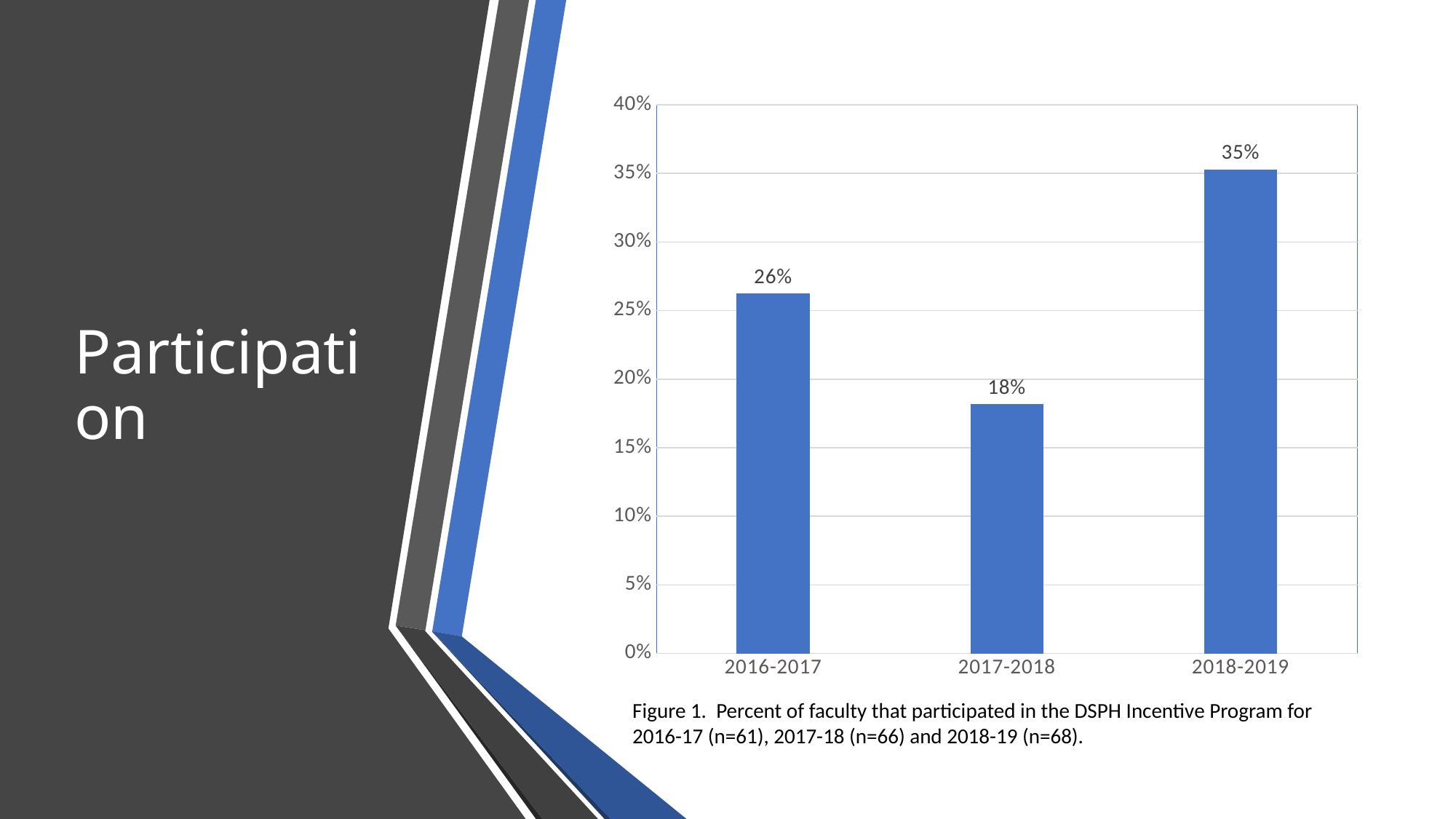
How many years are shown on the x axis? 3 What is the value shown for 2018-2019? 35% What kind of chart is shown on the slide? Bar chart What percent of faculty participated in the DSPH Incentive Program in 2016-2017? 26% Which year has the lowest participation rate? 2017-2018 Which year has the highest participation rate? 2018-2019 What is the difference in percentage points between 2018-2019 and 2017-2018? 17% Is the value for 2018-2019 greater or less than 30%? greater Which is larger, the value for 2016-2017 or the value for 2017-2018? 2016-2017 What is the maximum value shown on the y axis? 40% What is the value shown for 2017-2018? 18% What is the difference in percentage points between 2016-2017 and 2017-2018? 8%